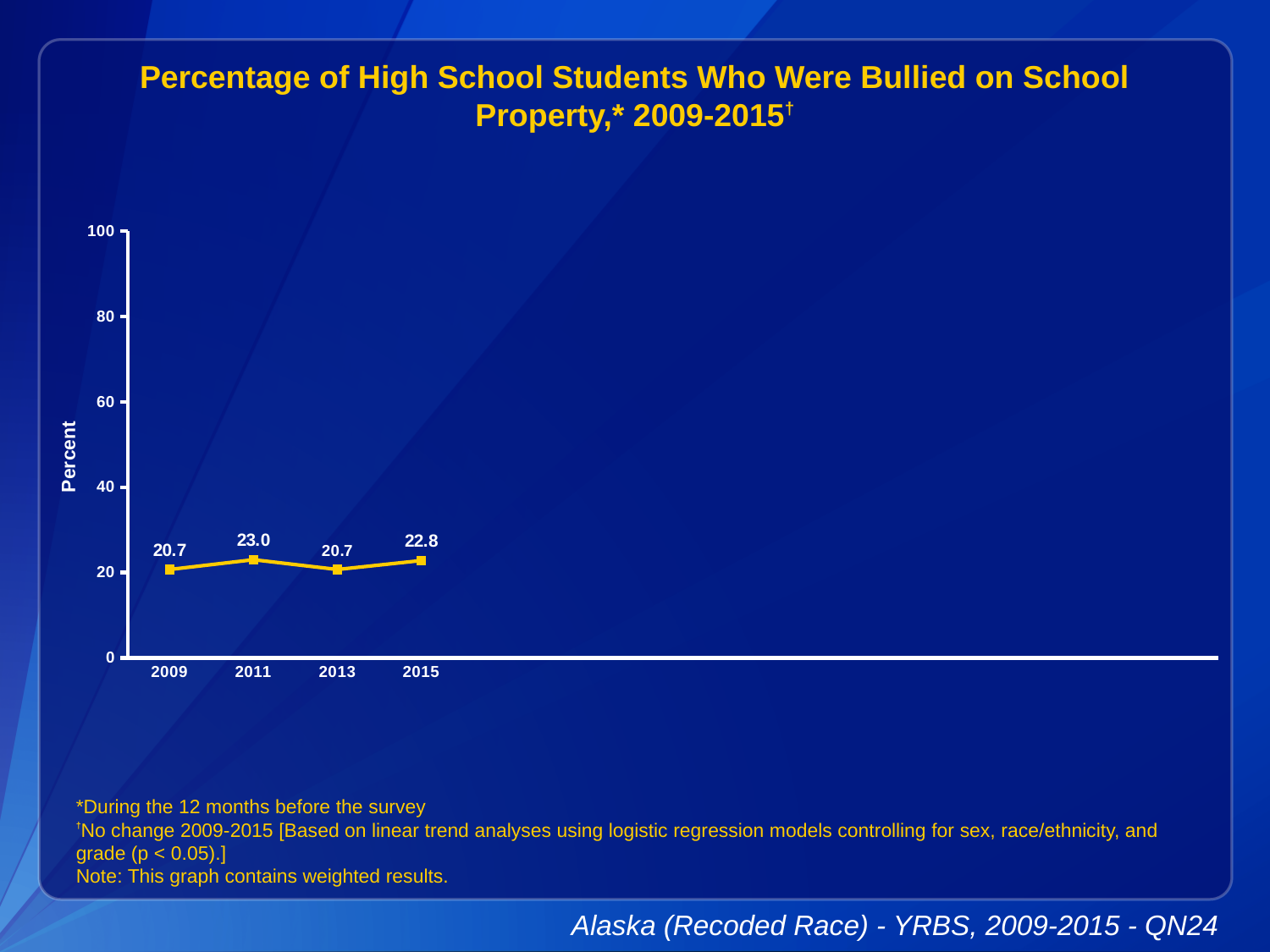
Which year has the highest value? 2011 What is the label of the y axis? Percent How many years are plotted on the chart? 4 What kind of chart is shown on the slide? line chart What is the maximum value shown on the y axis? 100 Is the value for 2013 greater or less than 40? less What is the difference between the values for 2011 and 2009? 2.3 Which is larger, the value for 2011 or the value for 2013? 2011 What is the value for 2011? 23.0 What is the difference between the values for 2015 and 2013? 2.1 What is the value for 2015? 22.8 What is the value for 2009? 20.7